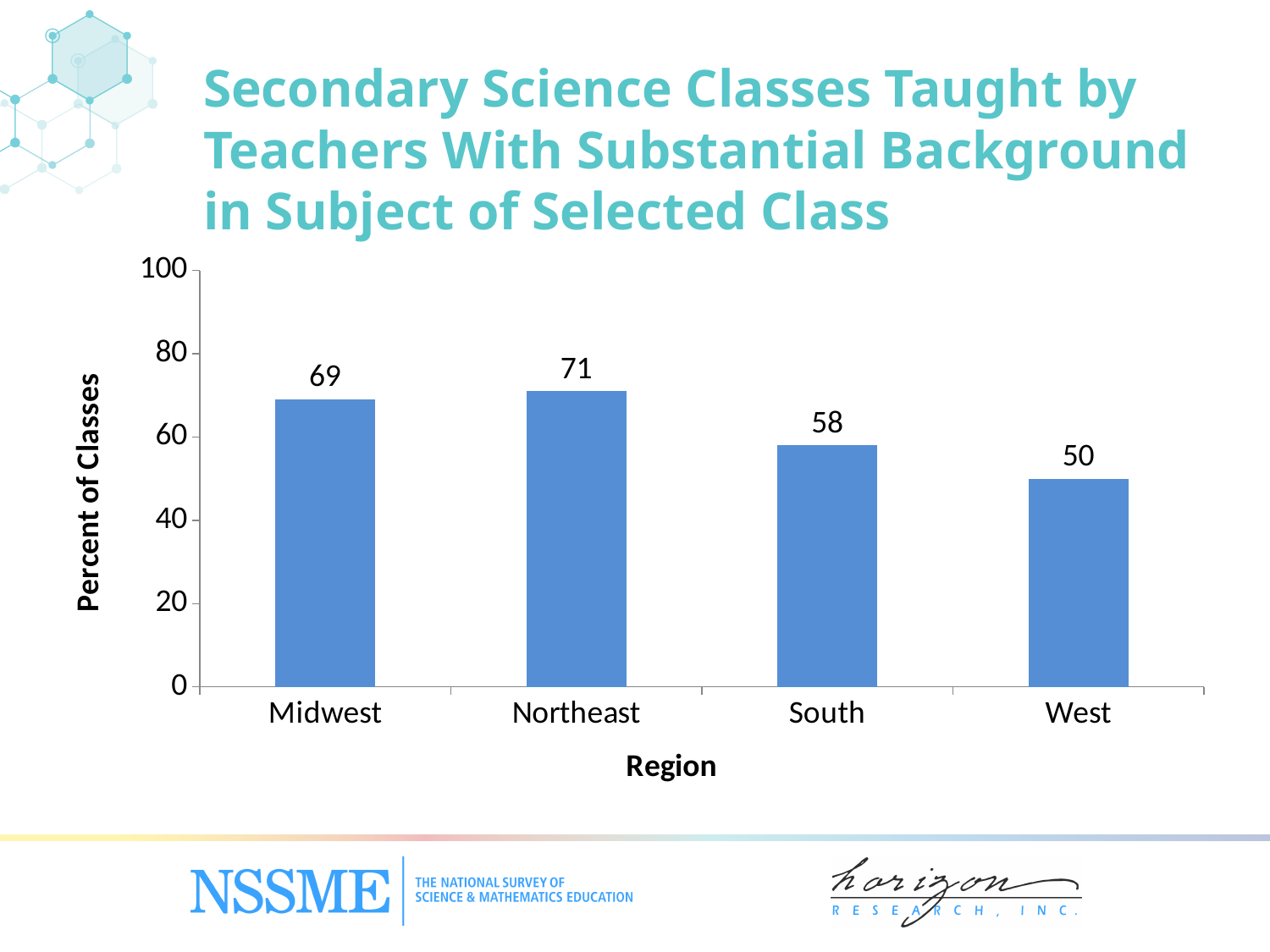
What is the value for the Midwest region? 69 How many regions are shown on the x axis? 4 What is the value for the Northeast region? 71 Which region has the lowest percent of classes? West What is the label of the y axis? Percent of Classes What is the value for the South region? 58 Which is larger, the value for the South or the value for the West? South What is the value for the West region? 50 What kind of chart is shown on the slide? Bar chart What is the difference between the values for the Northeast and the West? 21 What is the difference between the values for the Midwest and the South? 11 Which region has the highest percent of classes? Northeast